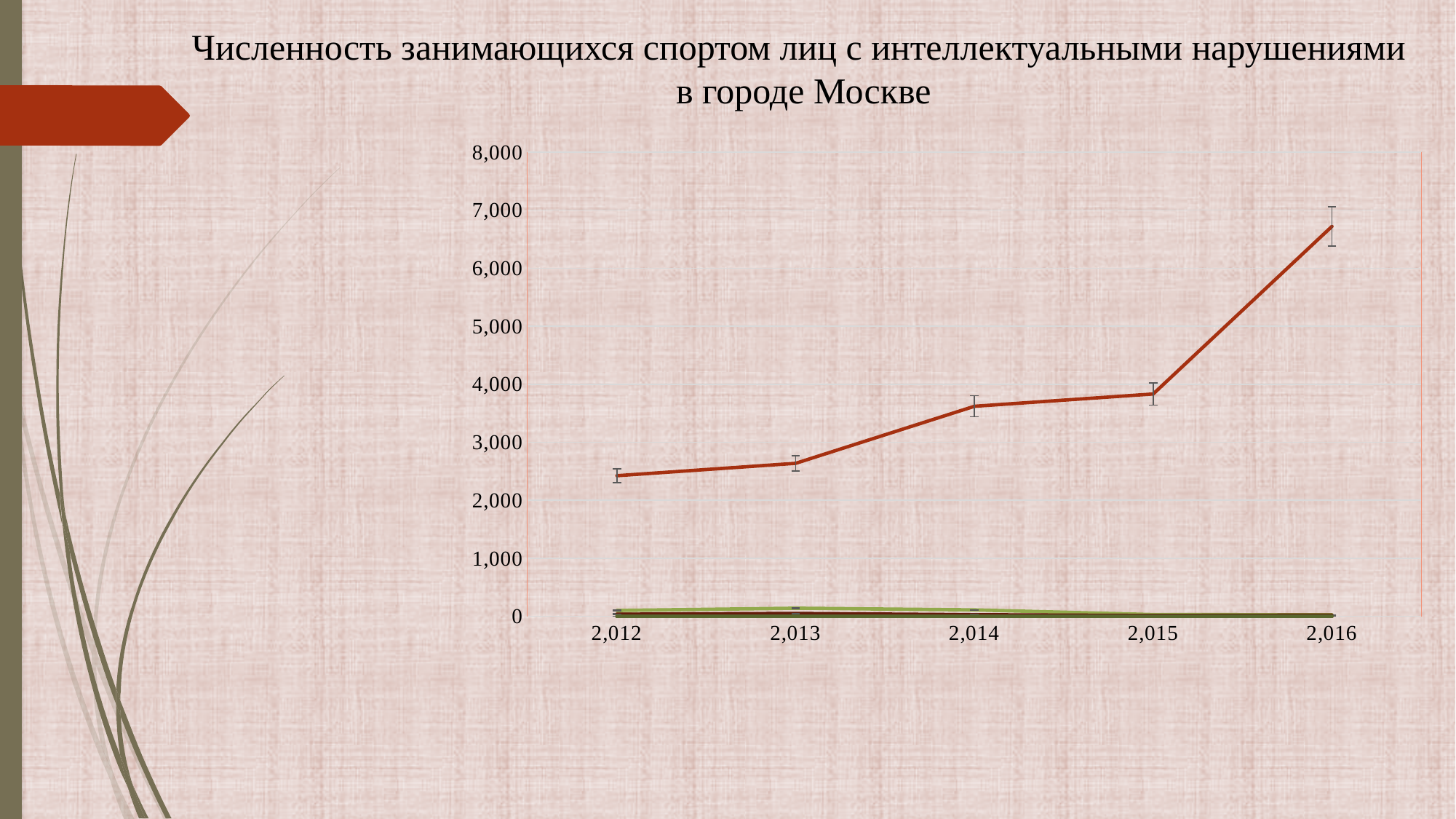
Is the value of the red line for 2,016 greater or less than 6,000? greater In which year does the red line reach its highest value? 2,016 How many years are shown along the x axis of the chart? 5 Which year has the larger value on the red line, 2,013 or 2,015? 2,015 What is the title of the chart on the slide? Численность занимающихся спортом лиц с интеллектуальными нарушениями в городе Москве In which year does the red line have its lowest value? 2,012 Is the value of the red line for 2,012 greater or less than 3,000? less Does the red line rise or fall from 2,012 to 2,016? rise What is the highest value shown on the vertical axis of the chart? 8,000 What kind of chart is shown on the slide? line chart Is the value of the red line for 2,014 greater or less than 3,000? greater